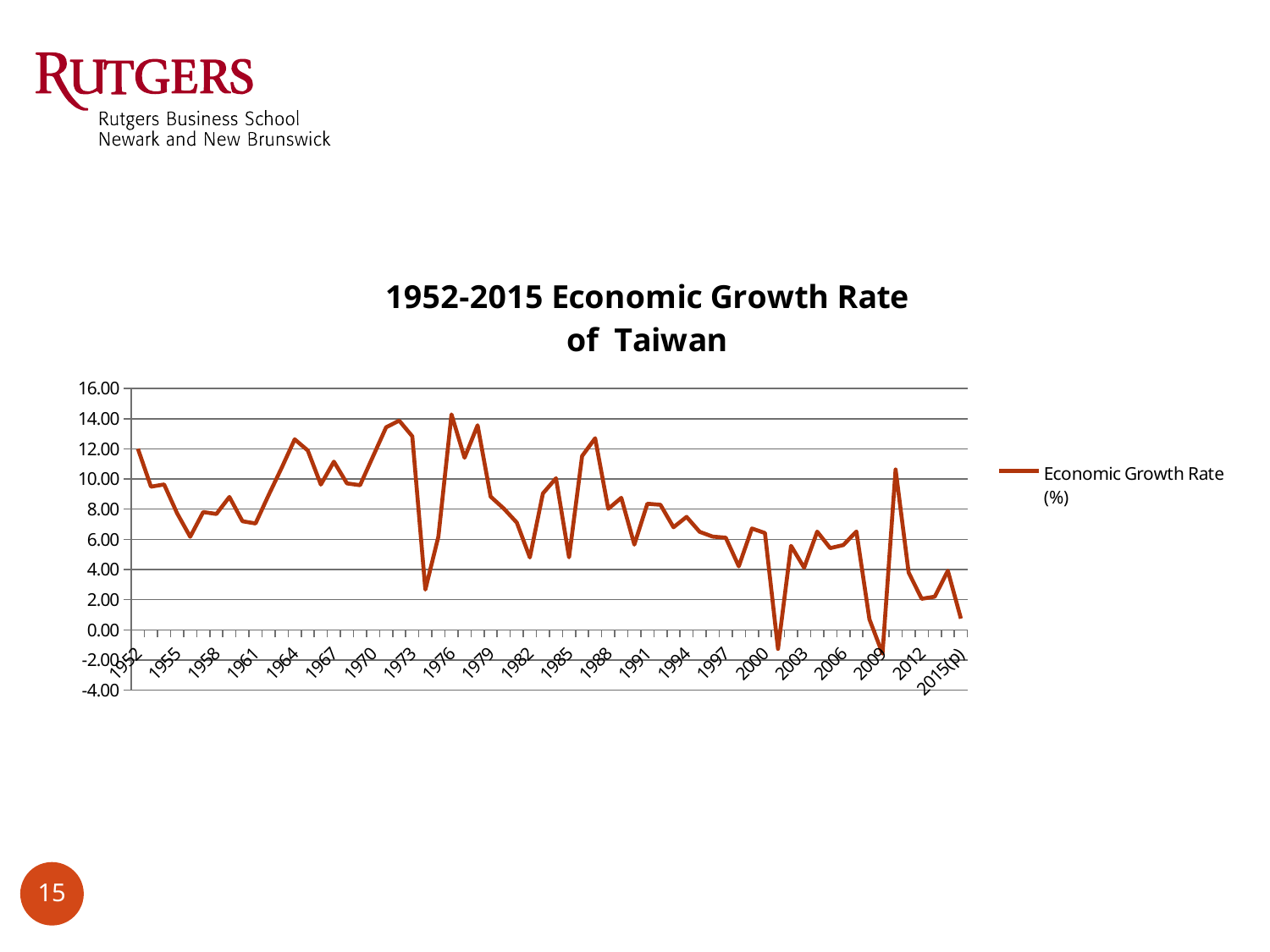
What is the title of the chart? 1952-2015 Economic Growth Rate of Taiwan What kind of chart is shown on the slide? line chart Which is larger, the value for 1952 or the value for 2015(p)? 1952 Is the value for 2001 greater or less than 2.00? less Is the value for 1974 greater or less than 4.00? less Is the value for 2010 greater or less than 8.00? greater How many series does the legend list? 1 Overall, do the values rise or fall from 1952 to 2015(p)? fall What is the legend entry for the plotted line? Economic Growth Rate (%)